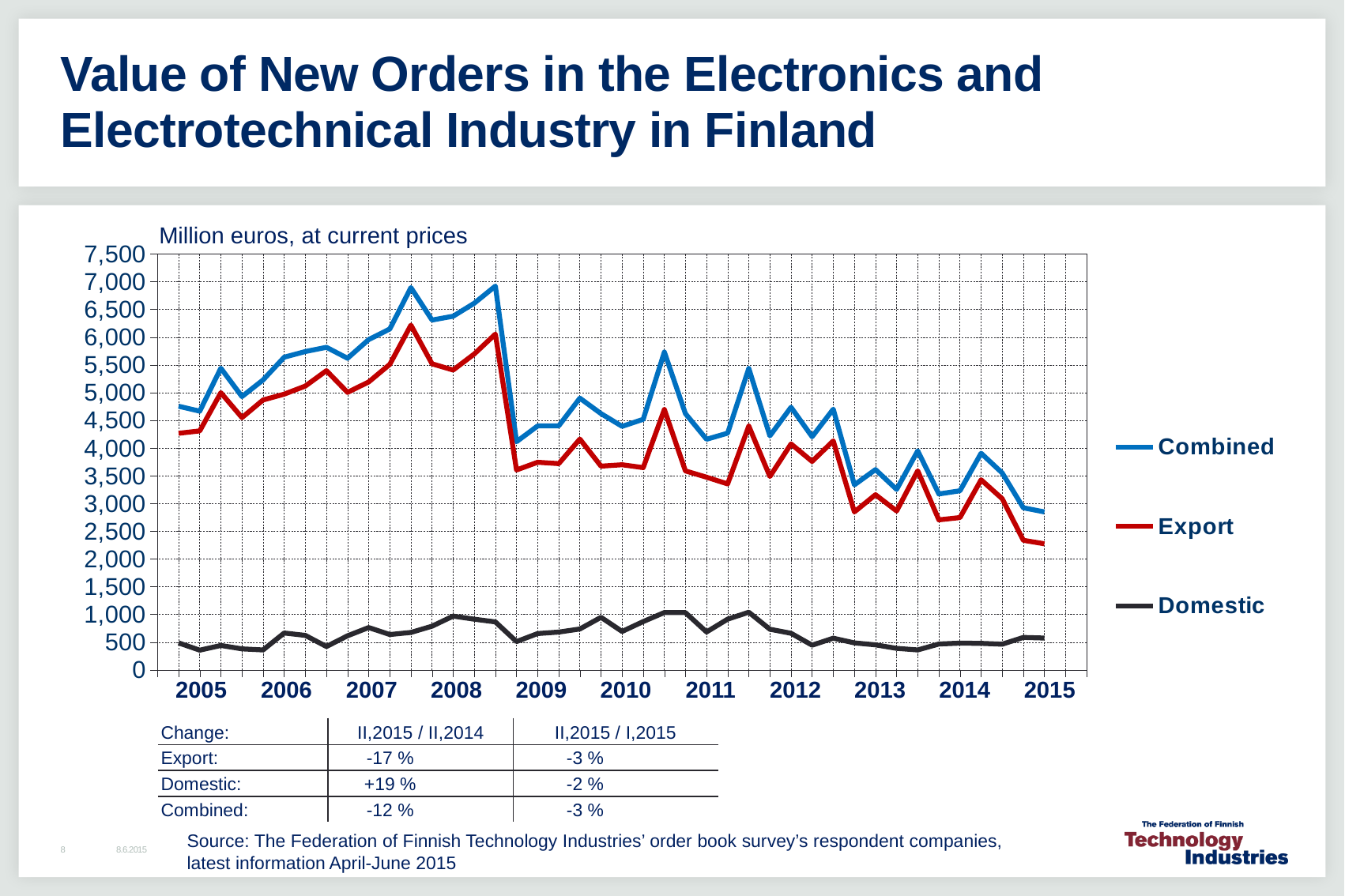
Which series has the lowest values throughout the chart? Domestic What kind of chart is shown on the slide? line chart Does the Combined series rise or fall from 2008 to 2015? fall How many year labels are shown on the x axis? 11 Which is larger in 2010, Export or Domestic? Export Which series has the highest values throughout the chart? Combined Is the peak value of Combined in 2008 greater or less than 6,500? greater Which series are listed in the legend? Combined, Export, Domestic How many series does the legend list? 3 Is the value for Domestic ever greater or less than 1,500? less Is the value for Export at the end of 2015 greater or less than 2,500? less What unit is stated above the chart? Million euros, at current prices